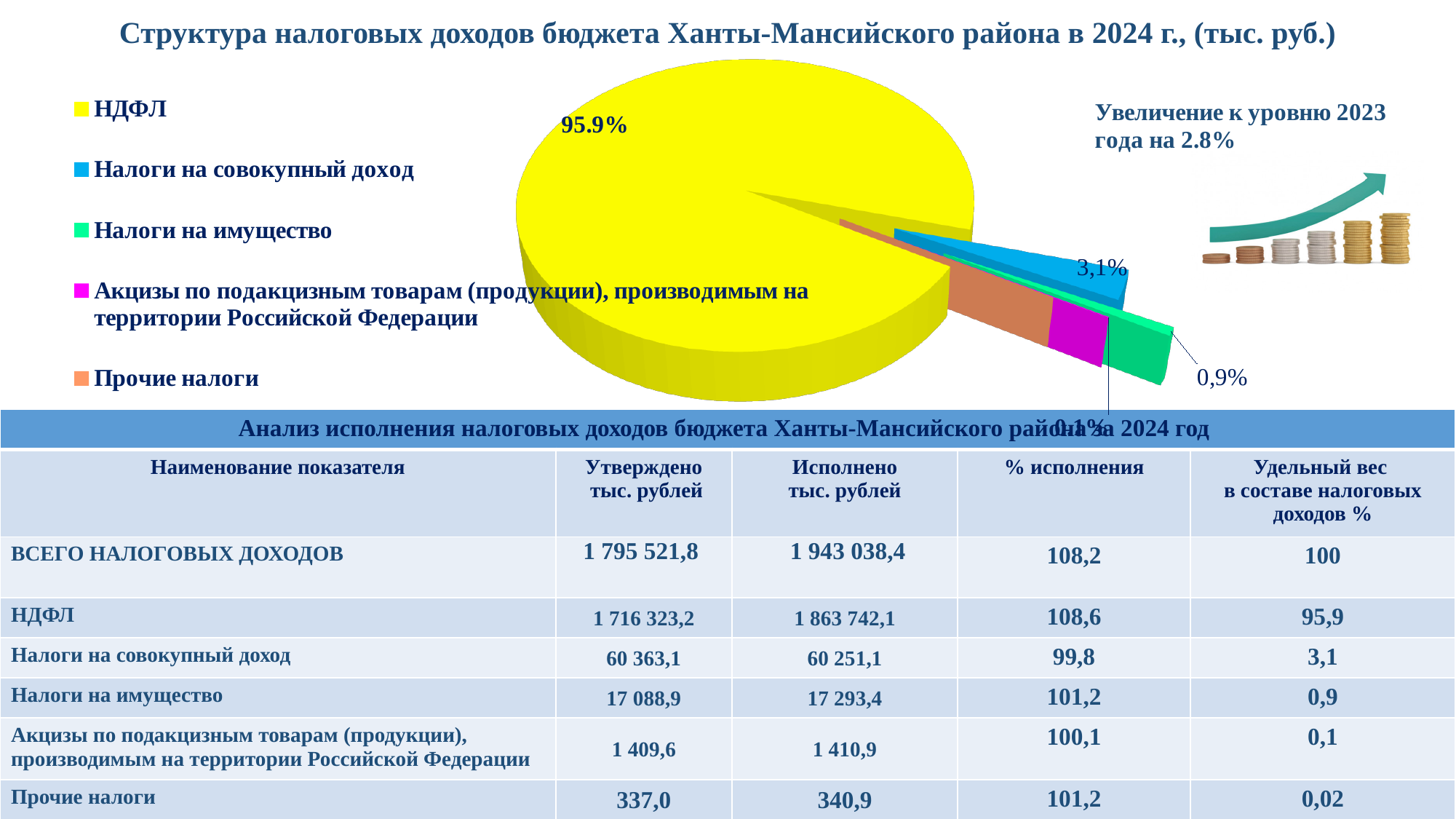
Which is larger in the pie chart: Налоги на совокупный доход or Налоги на имущество? Налоги на совокупный доход How many categories does the legend of the pie chart list? 5 What colour is the НДФЛ slice in the pie chart? yellow What is the value shown for Налоги на совокупный доход in the pie chart? 3,1% Which is larger in the pie chart: НДФЛ or Налоги на совокупный доход? НДФЛ What is the value shown for Налоги на имущество in the pie chart? 0,9% What kind of chart is shown on the slide? pie chart Which category has the largest slice of the pie chart? НДФЛ What is the title of the pie chart? Структура налоговых доходов бюджета Ханты-Мансийского района в 2024 г., (тыс. руб.) What share of the pie does НДФЛ account for? 95.9%